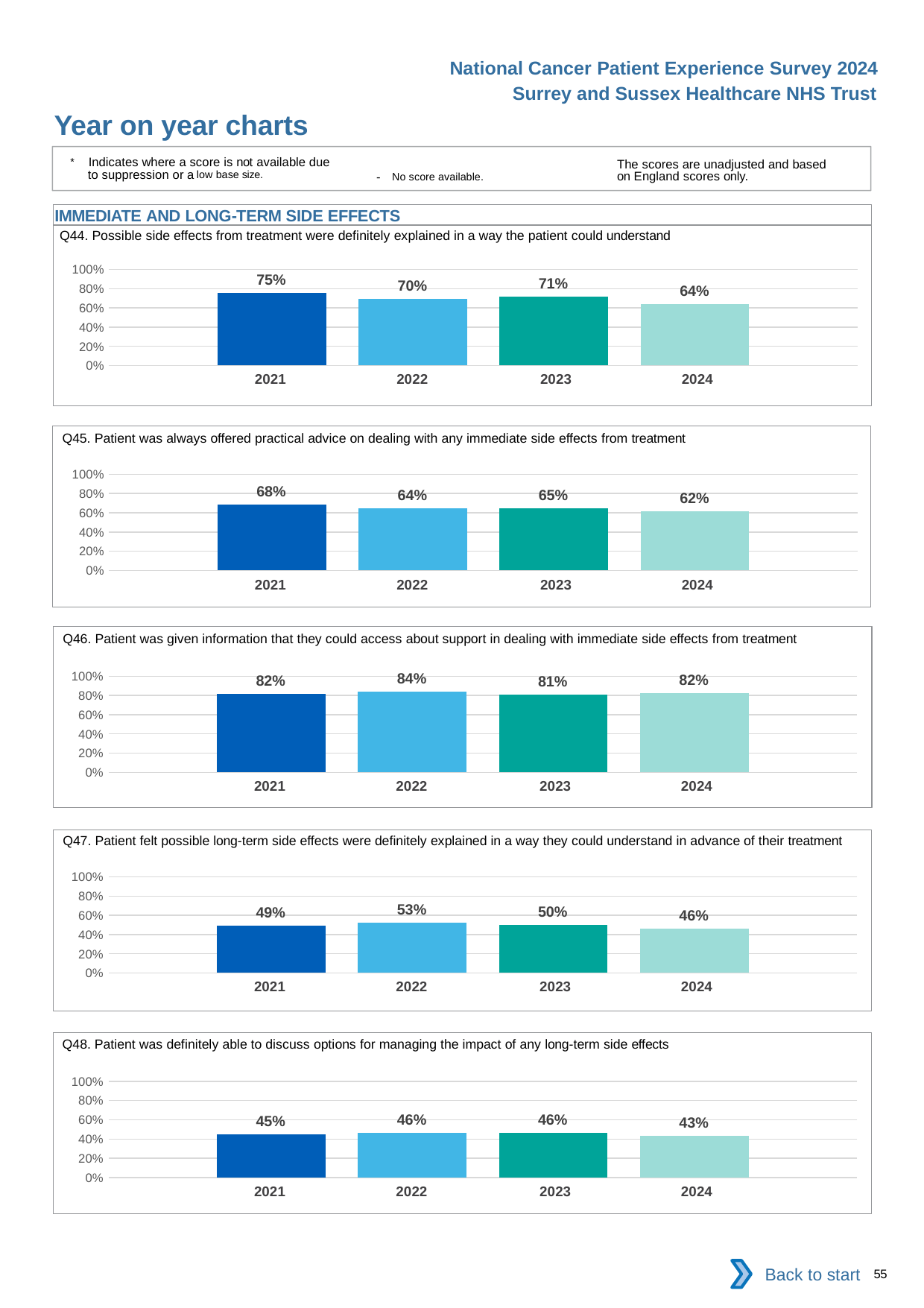
How many years are shown in the Q44 chart? 4 In the Q45 chart, what is the difference between the 2021 and 2024 values? 6 percentage points In the Q46 chart, which year has the lowest value? 2023 In the Q47 chart, which is larger, the value for 2022 or the value for 2024? 2022 What type of chart is the Q48 chart? Bar chart In the Q44 chart, what is the value for 2024? 64% In the Q44 chart, which year has the highest value? 2021 In the Q48 chart, what is the difference between the 2022 and 2024 values? 3 percentage points In the Q45 chart, which year has the lowest value? 2024 In the Q48 chart, what is the value for 2024? 43% In the Q46 chart, what is the value for 2022? 84% In the Q47 chart, what is the value for 2023? 50%